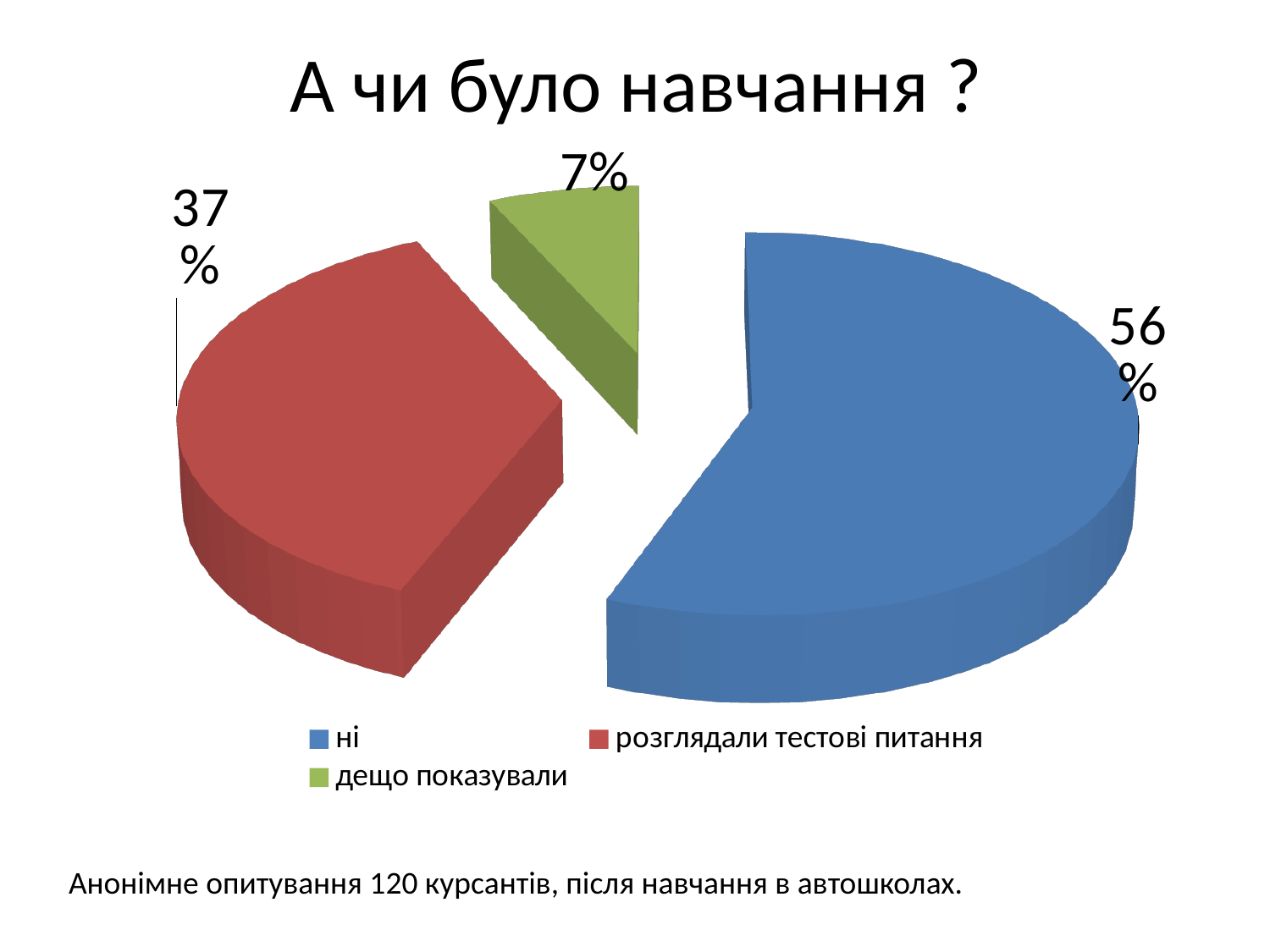
Which is larger: the share for "розглядали тестові питання" or the share for "дещо показували"? розглядали тестові питання What colour is the "ні" slice? blue Which category has the smallest share of the pie? дещо показували What percentage is shown for the "ні" slice? 56% What is the difference in percentage points between the "ні" slice and the "розглядали тестові питання" slice? 19 What is the combined share of "розглядали тестові питання" and "дещо показували"? 44% What percentage is shown for the "розглядали тестові питання" slice? 37% How many slices does the pie chart have? 3 What kind of chart is shown on the slide? pie chart What is the title of the chart? А чи було навчання ? Which category has the largest share of the pie? ні What percentage is shown for the "дещо показували" slice? 7%